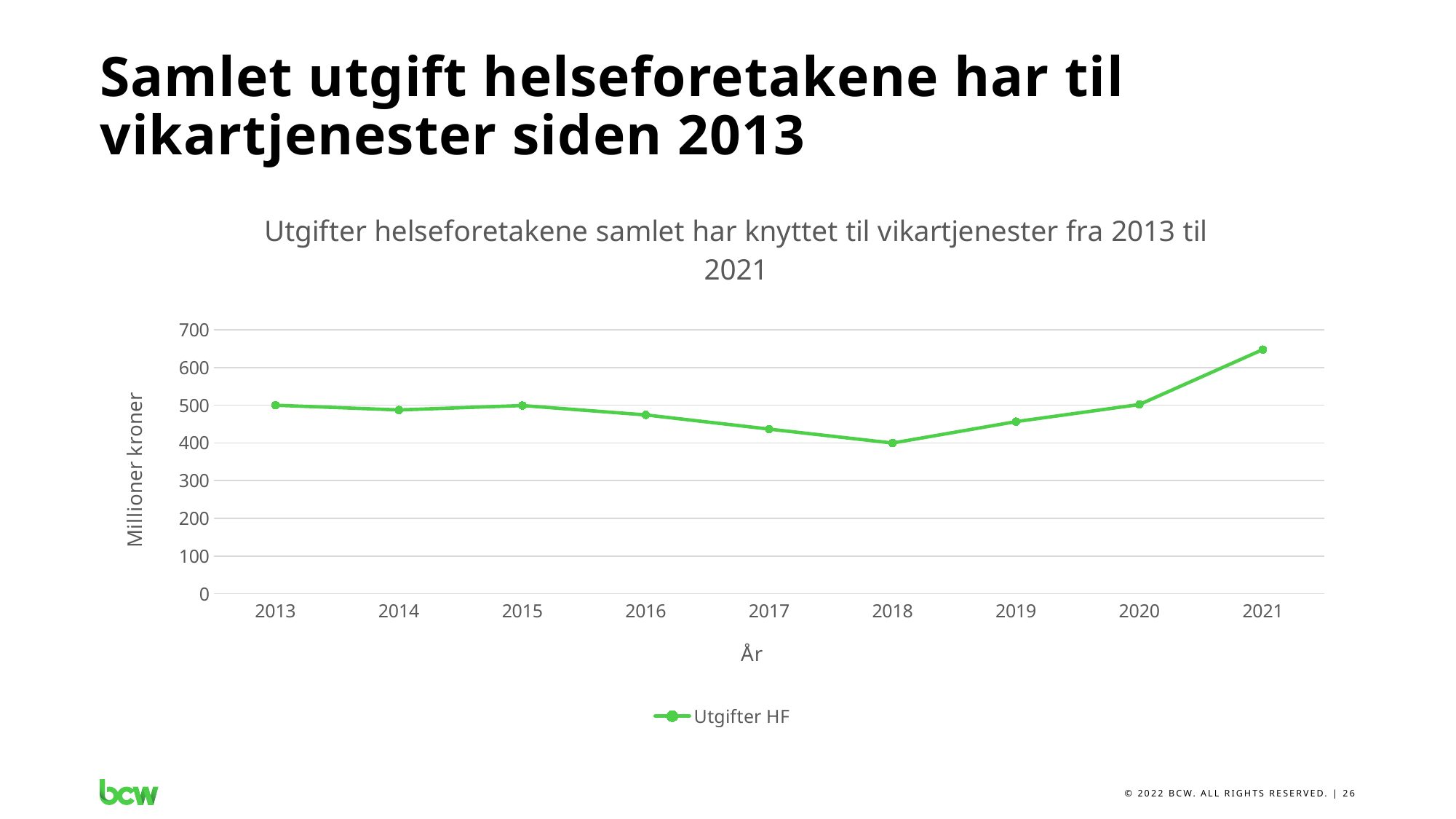
How many series does the legend list? 1 Which is larger, the value for 2013 or the value for 2021? 2021 Which year has the lowest value for Utgifter HF? 2018 Is the value for 2016 greater or less than 500? less Do the values rise or fall from 2018 to 2021? rise Is the value for 2021 greater or less than 600? greater What kind of chart is shown on the slide? line chart Which is larger, the value for 2017 or the value for 2018? 2017 How many years are plotted on the x axis? 9 Which year has the highest value for Utgifter HF? 2021 Is the value for 2018 greater or less than 450? less